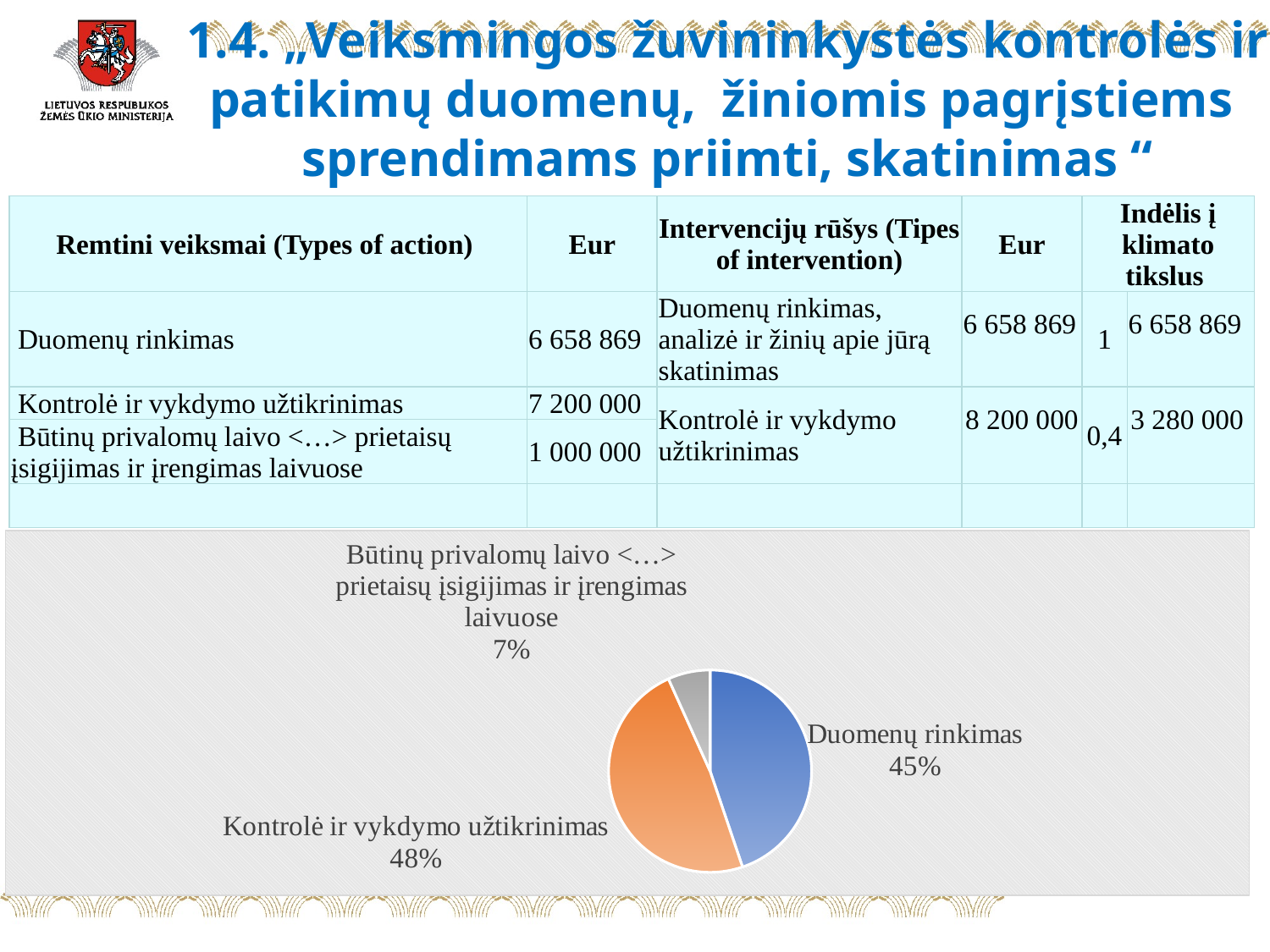
What type of chart is shown on the slide? pie chart What is the difference in percentage points between the "Kontrolė ir vykdymo užtikrinimas" slice and the "Duomenų rinkimas" slice? 3 How many slices does the pie chart have? 3 Which is larger in the pie chart: "Duomenų rinkimas" or "Būtinų privalomų laivo <…> prietaisų įsigijimas ir įrengimas laivuose"? Duomenų rinkimas What share of the pie does "Duomenų rinkimas" have? 45% What share of the pie does "Kontrolė ir vykdymo užtikrinimas" have? 48% What colour is the "Kontrolė ir vykdymo užtikrinimas" slice in the pie chart? orange Which slice of the pie chart is the largest? Kontrolė ir vykdymo užtikrinimas What share of the pie does "Būtinų privalomų laivo <…> prietaisų įsigijimas ir įrengimas laivuose" have? 7% What colour is the "Duomenų rinkimas" slice in the pie chart? blue Which slice of the pie chart is the smallest? Būtinų privalomų laivo <…> prietaisų įsigijimas ir įrengimas laivuose What is the difference in percentage points between the "Duomenų rinkimas" slice and the "Būtinų privalomų laivo <…> prietaisų įsigijimas ir įrengimas laivuose" slice? 38